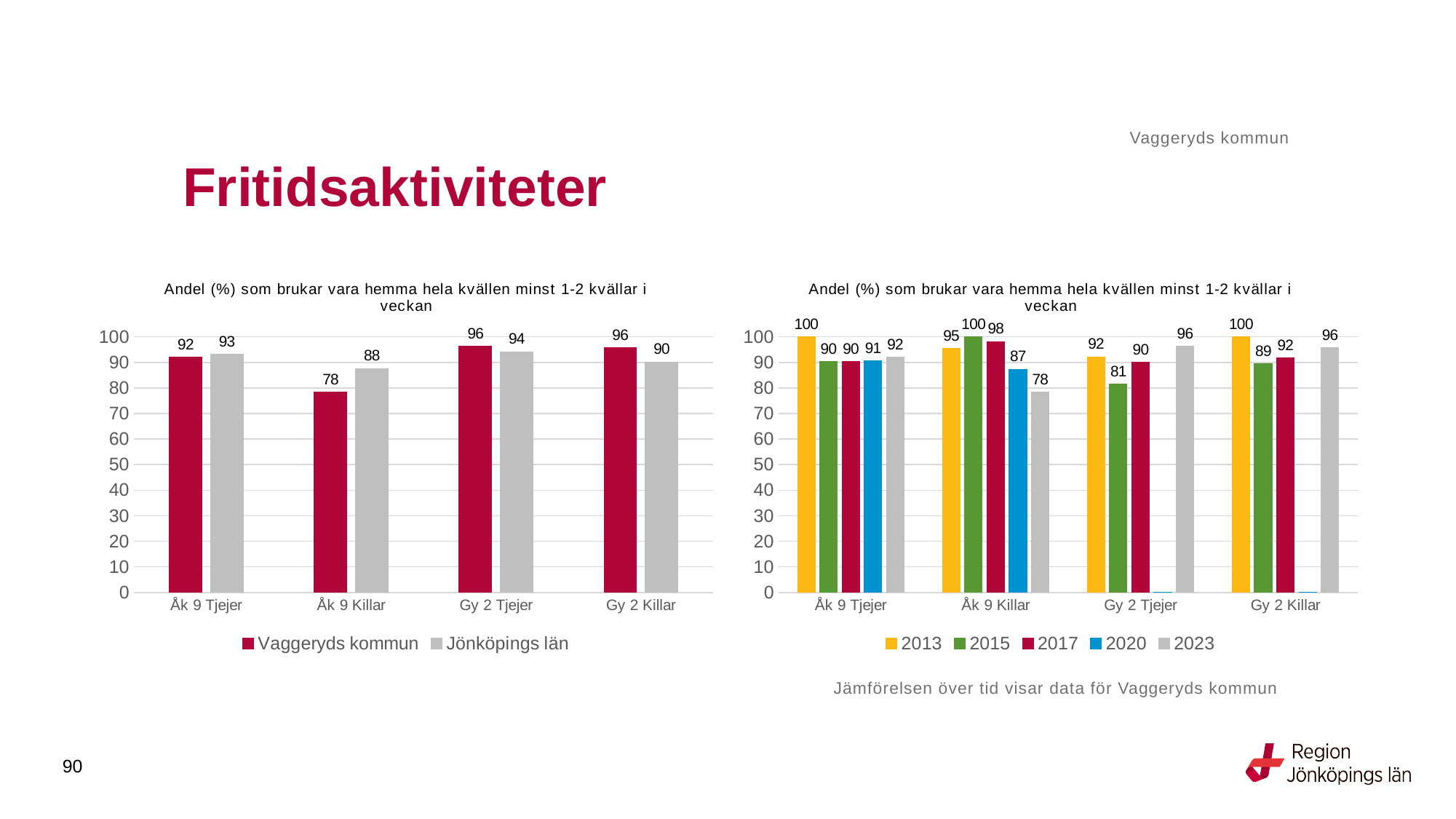
What type of chart is the right chart? Bar chart In the right chart, what is the value for 2020 for Åk 9 Killar? 87 In the right chart, how many series does the legend list? 5 In the right chart, what is the value for 2015 for Gy 2 Tjejer? 81 In the left chart, which is larger for Gy 2 Tjejer: Vaggeryds kommun or Jönköpings län? Vaggeryds kommun In the right chart, what is the difference between the 2013 and 2023 values for Åk 9 Tjejer? 8 In the left chart, what is the value for Jönköpings län for Gy 2 Killar? 90 In the right chart, which year has the lowest value for Åk 9 Killar? 2023 In the left chart, what is the value for Vaggeryds kommun for Åk 9 Killar? 78 In the left chart, what is the difference between Jönköpings län and Vaggeryds kommun for Åk 9 Killar? 10 In the left chart, how many series does the legend list? 2 In the left chart, which category has the lowest value for Vaggeryds kommun? Åk 9 Killar